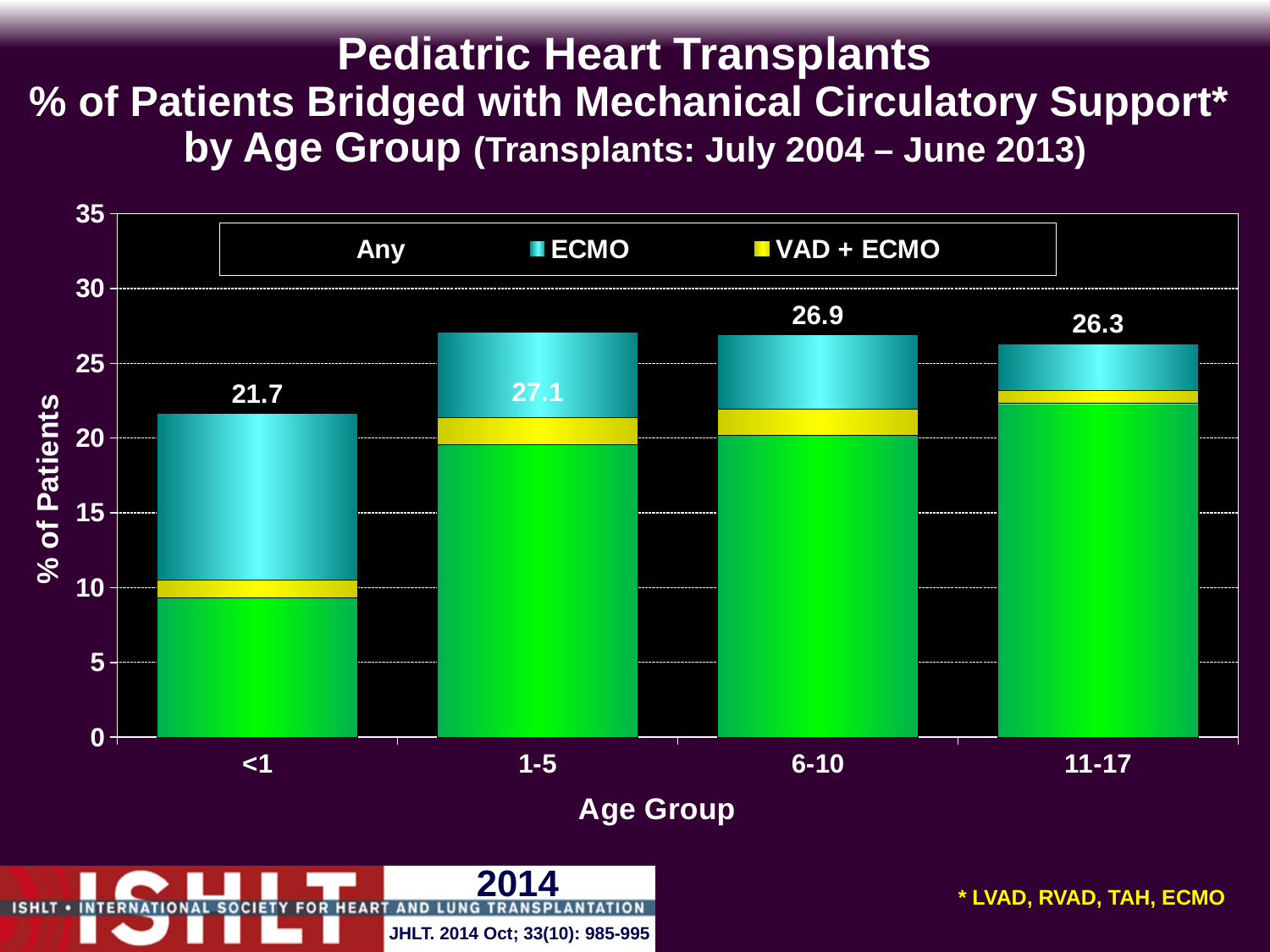
Is the value of the green 'Any' segment for the <1 age group greater or less than 10? less What kind of chart is shown on the slide? Stacked bar chart What is the total percentage labelled for the 11-17 age group? 26.3 Is the value of the green 'Any' segment for the 11-17 age group greater or less than 20? greater Which age group has the lowest total percentage of patients bridged with mechanical circulatory support? <1 What is the total percentage of patients bridged with mechanical circulatory support in the <1 age group? 21.7 Which age group has a larger total percentage, <1 or 11-17? 11-17 What is the total percentage labelled above the bar for the 1-5 age group? 27.1 How many age groups are shown on the x axis? 4 Which age group has the highest total percentage of patients bridged with mechanical circulatory support? 1-5 What is the difference between the total percentages for the 1-5 and <1 age groups? 5.4 How many series does the legend list? 3